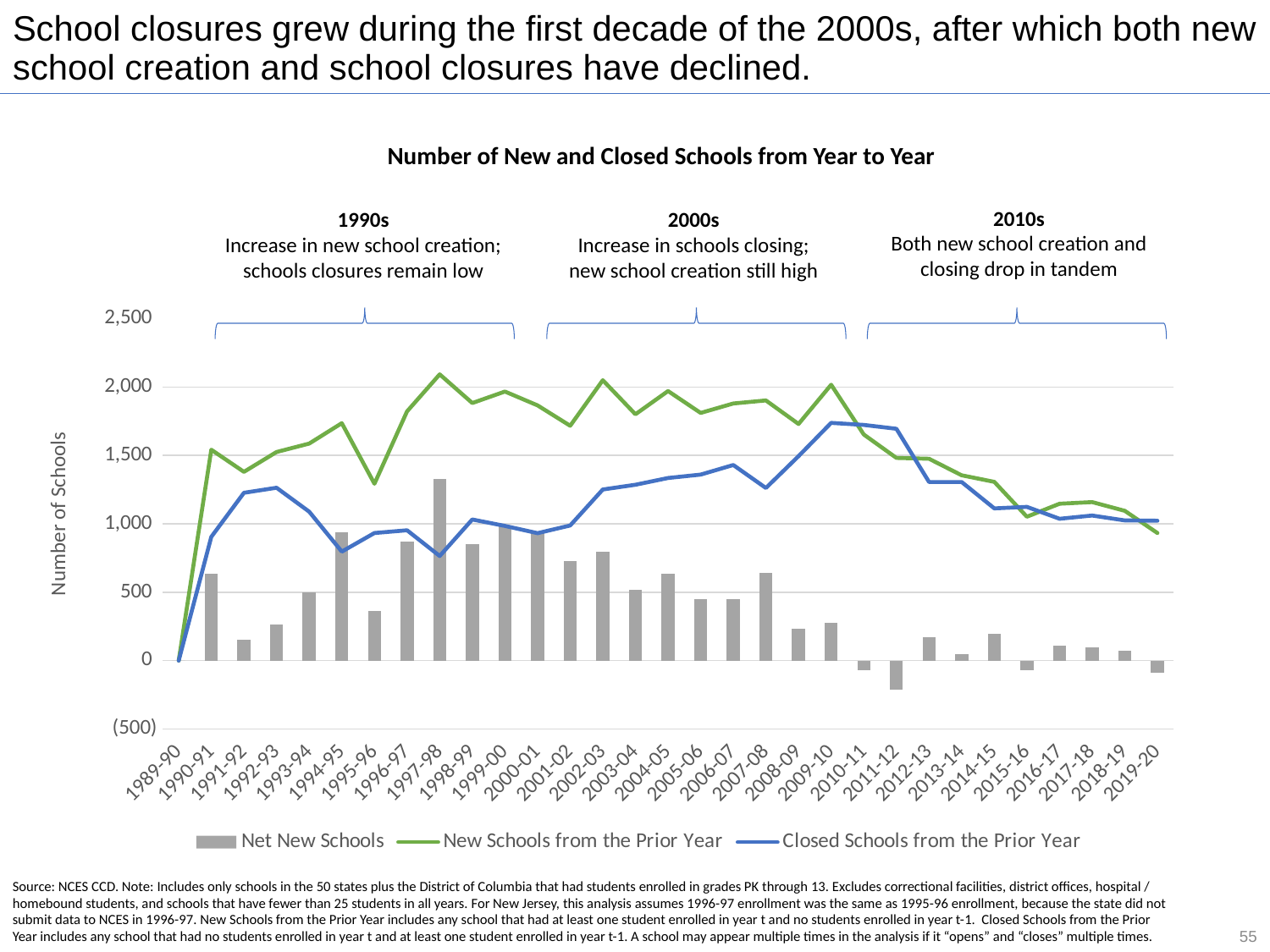
What is the title of the chart? Number of New and Closed Schools from Year to Year Which school year has the tallest Net New Schools bar? 1997-98 Which school year has the lowest Net New Schools bar? 2011-12 How many series does the legend list? 3 Is the value for New Schools from the Prior Year in 2019-20 greater or less than 1,000? less Which school year has the highest value for Closed Schools from the Prior Year? 2009-10 Does the Closed Schools from the Prior Year line rise or fall from 2009-10 to 2019-20? fall Is the value for Closed Schools from the Prior Year in 2009-10 greater or less than 1,500? greater How many school years are shown along the x axis? 31 Is the Net New Schools value for 2011-12 greater or less than 0? less What kind of chart is shown on the slide? Combined bar and line chart